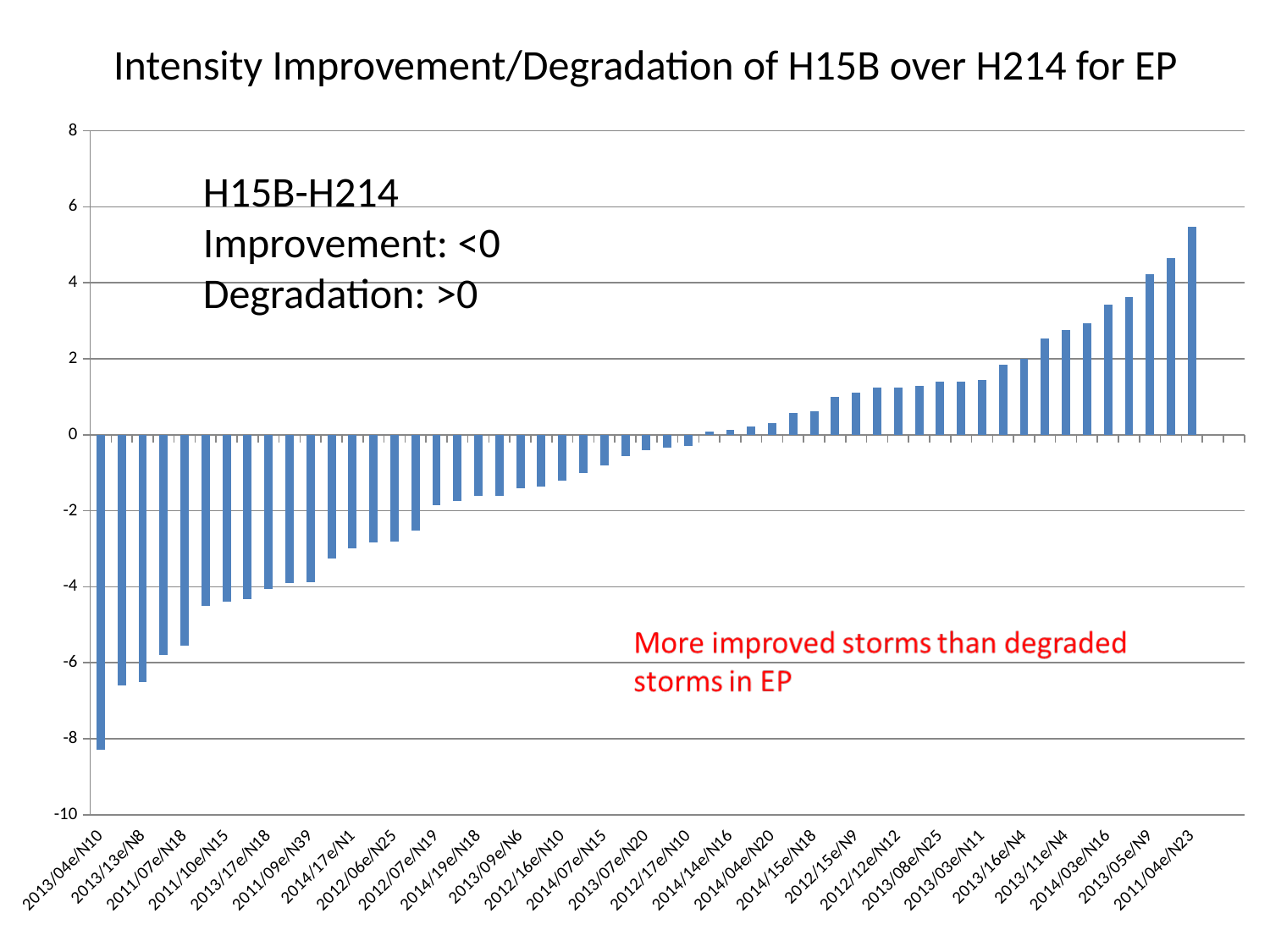
Which category has the lowest value in the chart? 2013/04e/N10 Which category has the highest value in the chart? 2011/04e/N23 Is the value for 2013/04e/N10 greater or less than -8? less Is the value for 2011/04e/N23 greater or less than 4? greater Is the value for 2011/04e/N23 greater or less than 6? less What kind of chart is shown on the slide? bar chart Do the bar values rise or fall from left to right along the x axis? rise Which has the larger value, 2013/04e/N10 or 2011/04e/N23? 2011/04e/N23 According to the red annotation on the chart, are there more improved or more degraded storms in EP? more improved storms What is the title of the chart? Intensity Improvement/Degradation of H15B over H214 for EP